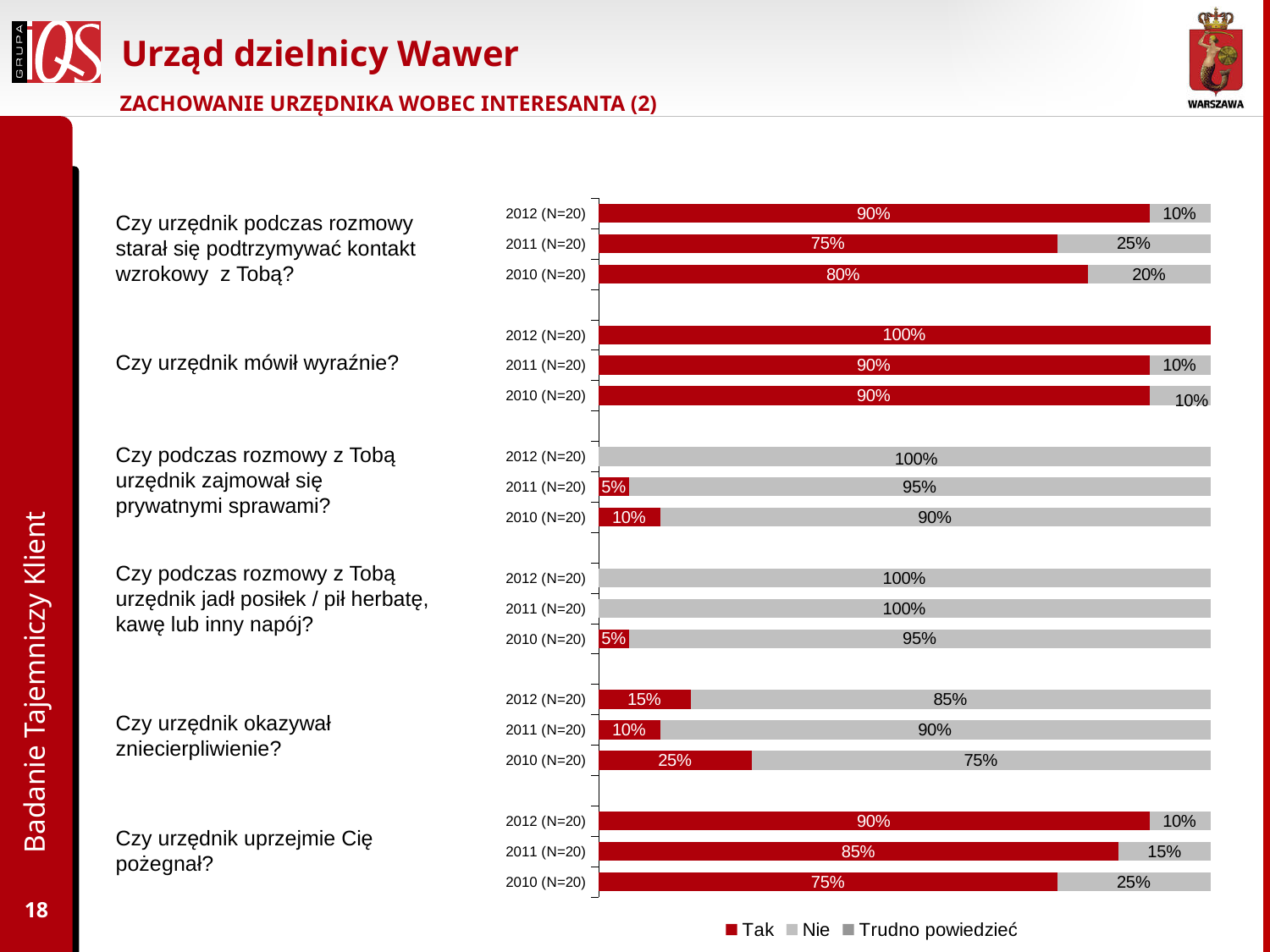
What type of chart is shown on the slide? Stacked bar chart What percentage answered "Nie" in 2011 (N=20) for "Czy urzędnik podczas rozmowy starał się podtrzymywać kontakt wzrokowy z Tobą?"? 25% What percentage answered "Tak" in 2012 (N=20) for "Czy urzędnik podczas rozmowy starał się podtrzymywać kontakt wzrokowy z Tobą?"? 90% What is the difference between the "Tak" percentages for 2012 (N=20) and 2010 (N=20) for "Czy urzędnik uprzejmie Cię pożegnał?"? 15% What percentage answered "Nie" in 2011 (N=20) for "Czy podczas rozmowy z Tobą urzędnik zajmował się prywatnymi sprawami?"? 95% What is the total of the stacked bar for 2011 (N=20) for "Czy urzędnik uprzejmie Cię pożegnał?"? 100% What percentage answered "Tak" in 2012 (N=20) for "Czy urzędnik mówił wyraźnie?"? 100% For "Czy urzędnik podczas rozmowy starał się podtrzymywać kontakt wzrokowy z Tobą?", which is larger: the "Tak" percentage in 2011 (N=20) or in 2010 (N=20)? 2010 (N=20) How many series does the chart legend list? 3 For "Czy urzędnik uprzejmie Cię pożegnał?", which year has the highest "Tak" percentage? 2012 (N=20) For "Czy urzędnik okazywał zniecierpliwienie?", which year has the lowest "Tak" percentage? 2011 (N=20) What percentage answered "Tak" in 2010 (N=20) for "Czy urzędnik okazywał zniecierpliwienie?"? 25%